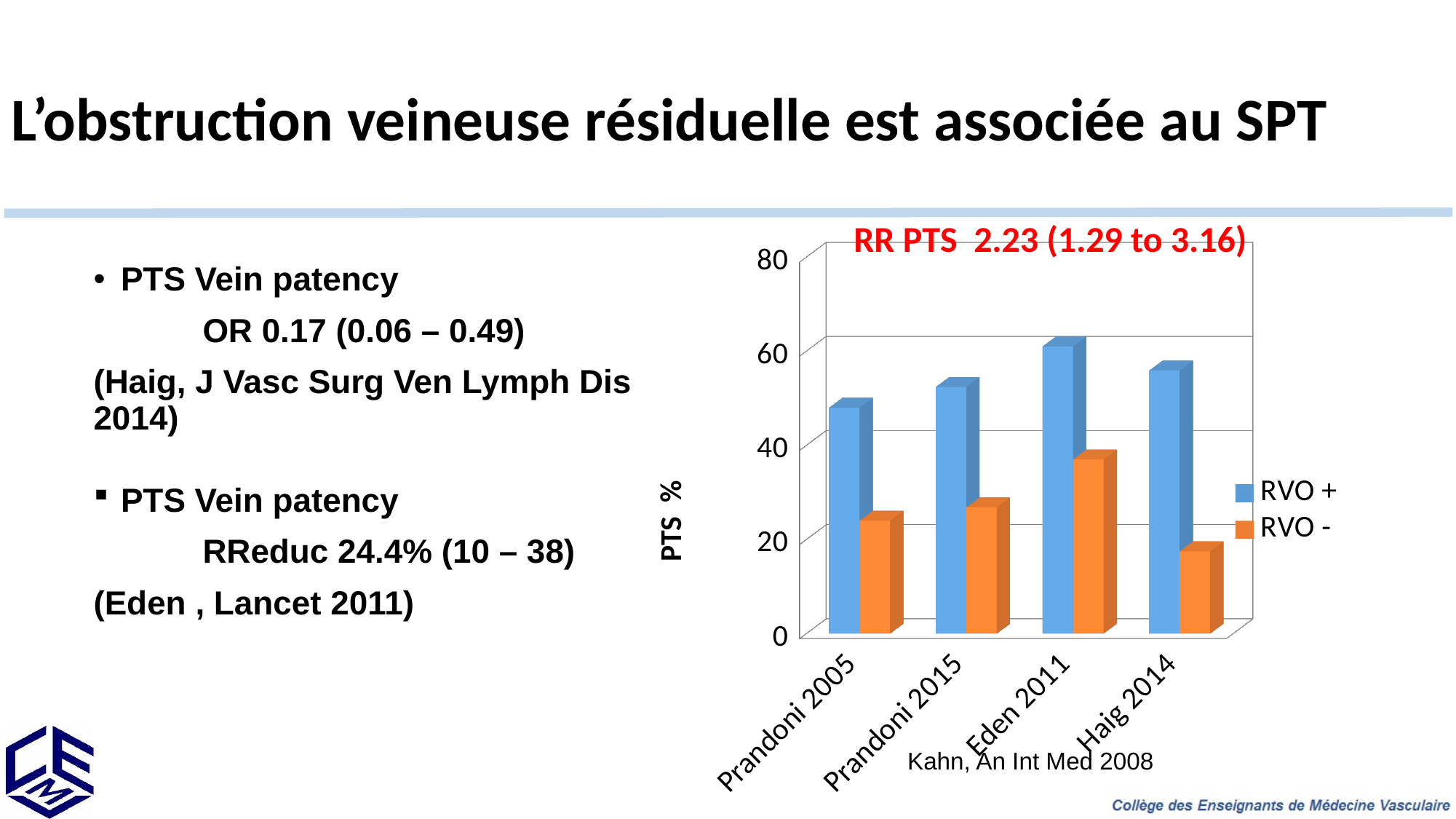
Which study has the lowest RVO + value? Prandoni 2005 Is the RVO + value for Prandoni 2005 greater or less than 40? greater For Haig 2014, which is larger, the RVO + value or the RVO - value? RVO + How many study categories are shown on the x axis of the chart? 4 How many series does the chart legend list? 2 What is the label of the vertical axis of the chart? PTS % Is the RVO - value for Haig 2014 greater or less than 20? less Which study has the highest RVO - value? Eden 2011 Which study has the highest RVO + value? Eden 2011 Which study has the lowest RVO - value? Haig 2014 What kind of chart is shown on the slide? bar chart